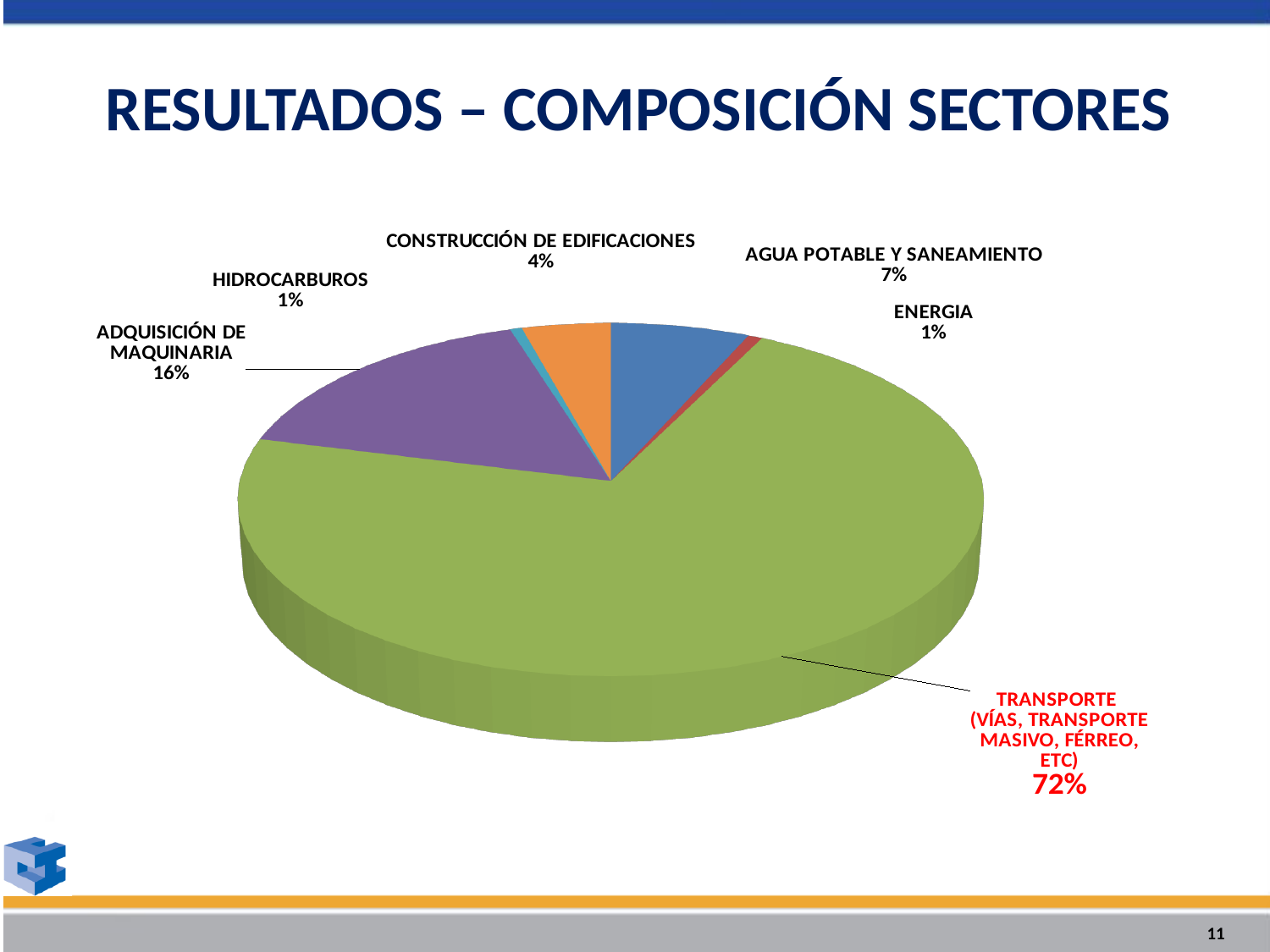
What is the difference between the shares of TRANSPORTE and ADQUISICIÓN DE MAQUINARIA? 56% What kind of chart is shown on the slide? Pie chart What is the value shown for CONSTRUCCIÓN DE EDIFICACIONES? 4% Which is larger, the share for AGUA POTABLE Y SANEAMIENTO or the share for CONSTRUCCIÓN DE EDIFICACIONES? AGUA POTABLE Y SANEAMIENTO Which sector has the largest share of the pie? TRANSPORTE (VÍAS, TRANSPORTE MASIVO, FÉRREO, ETC) What is the value shown for HIDROCARBUROS? 1% What is the value shown for ADQUISICIÓN DE MAQUINARIA? 16% What is the value shown for ENERGIA? 1% What share of the pie does TRANSPORTE (VÍAS, TRANSPORTE MASIVO, FÉRREO, ETC) represent? 72% What is the value shown for AGUA POTABLE Y SANEAMIENTO? 7% What is the title of the slide containing the pie chart? RESULTADOS – COMPOSICIÓN SECTORES How many sectors (slices) are shown in the pie chart? 6